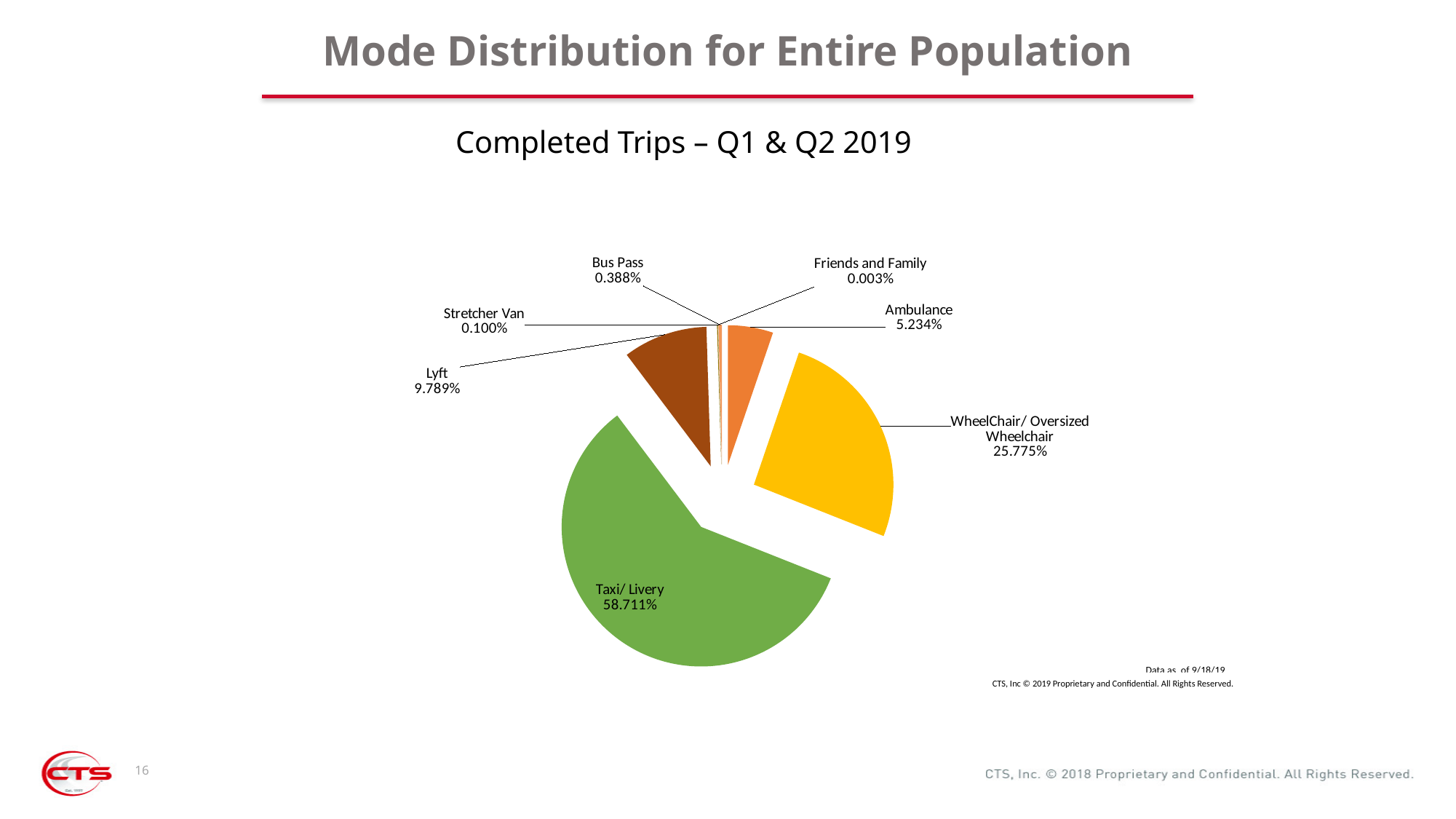
Which has a larger share, Lyft or Ambulance? Lyft What type of chart is shown on the slide? Pie chart What is the value shown for Friends and Family? 0.003% What percentage of completed trips is WheelChair/ Oversized Wheelchair? 25.775% What is the value shown for Lyft? 9.789% How many modes (slices) are shown in the pie chart? 7 Which mode has the largest share of completed trips? Taxi/ Livery What is the subtitle of the chart? Completed Trips – Q1 & Q2 2019 Which mode has the smallest share of completed trips? Friends and Family What share of completed trips is Taxi/ Livery? 58.711% What is the difference in percentage points between Taxi/ Livery and WheelChair/ Oversized Wheelchair? 32.936 What percentage is shown for Ambulance? 5.234%